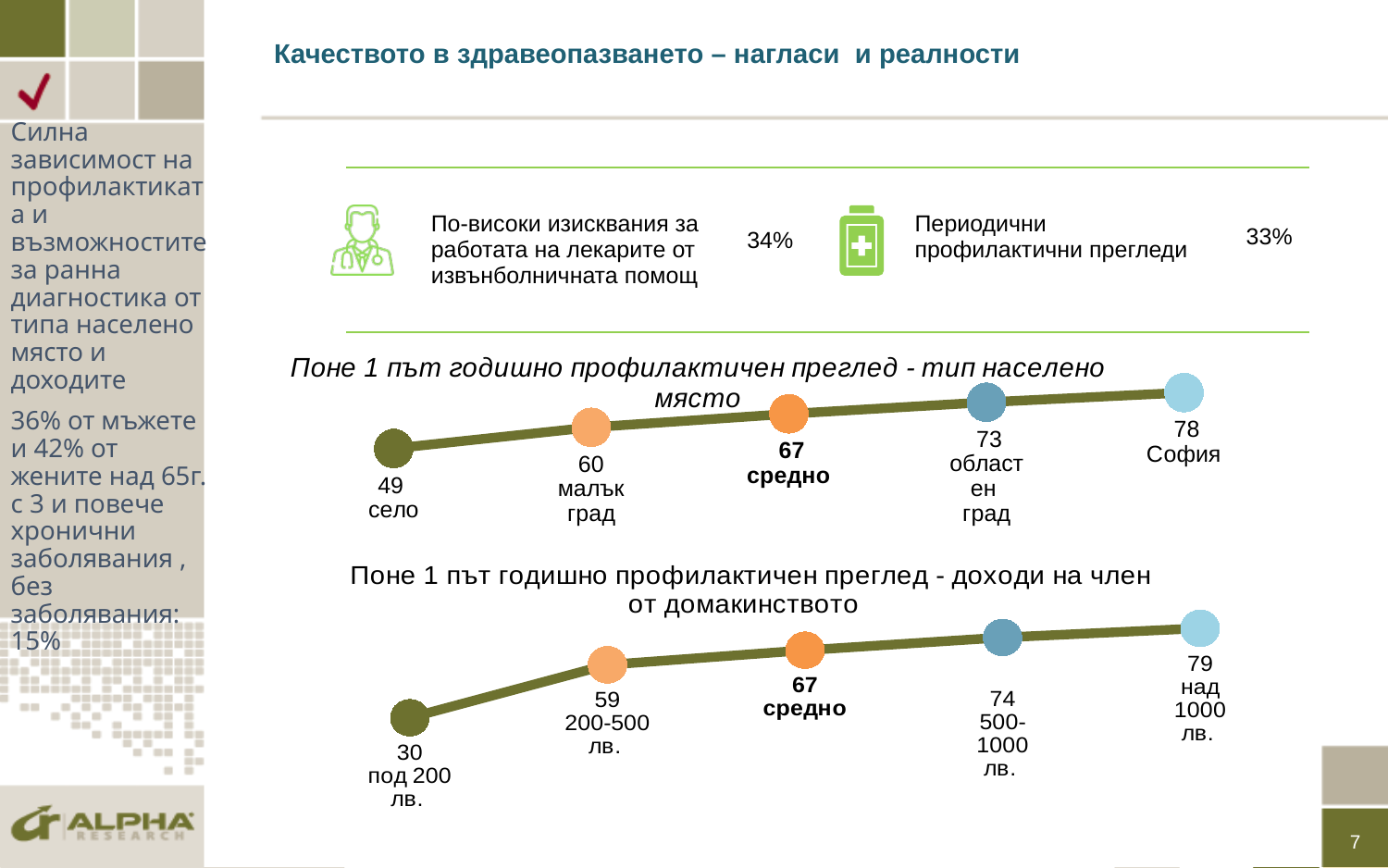
In the chart 'Поне 1 път годишно профилактичен преглед - тип населено място', do the values rise or fall from село to София? rise In the chart 'Поне 1 път годишно профилактичен преглед - доходи на член от домакинството', what is the difference between the values for 200-500 лв. and под 200 лв.? 29 In the chart 'Поне 1 път годишно профилактичен преглед - тип населено място', how many data points are plotted? 5 What type of chart is 'Поне 1 път годишно профилактичен преглед - доходи на член от домакинството'? line chart In the chart 'Поне 1 път годишно профилактичен преглед - тип населено място', what is the value for село? 49 In the chart 'Поне 1 път годишно профилактичен преглед - доходи на член от домакинството', what is the value for 500-1000 лв.? 74 In the chart 'Поне 1 път годишно профилактичен преглед - тип населено място', what is the difference between the values for София and село? 29 In the chart 'Поне 1 път годишно профилактичен преглед - доходи на член от домакинството', which is larger: the value for 500-1000 лв. or the value for средно? 500-1000 лв. In the chart 'Поне 1 път годишно профилактичен преглед - тип населено място', which category has the lowest value? село In the chart 'Поне 1 път годишно профилактичен преглед - доходи на член от домакинството', which category has the highest value? над 1000 лв. In the chart 'Поне 1 път годишно профилактичен преглед - тип населено място', what is the value for София? 78 In the chart 'Поне 1 път годишно профилактичен преглед - доходи на член от домакинството', what is the value for под 200 лв.? 30